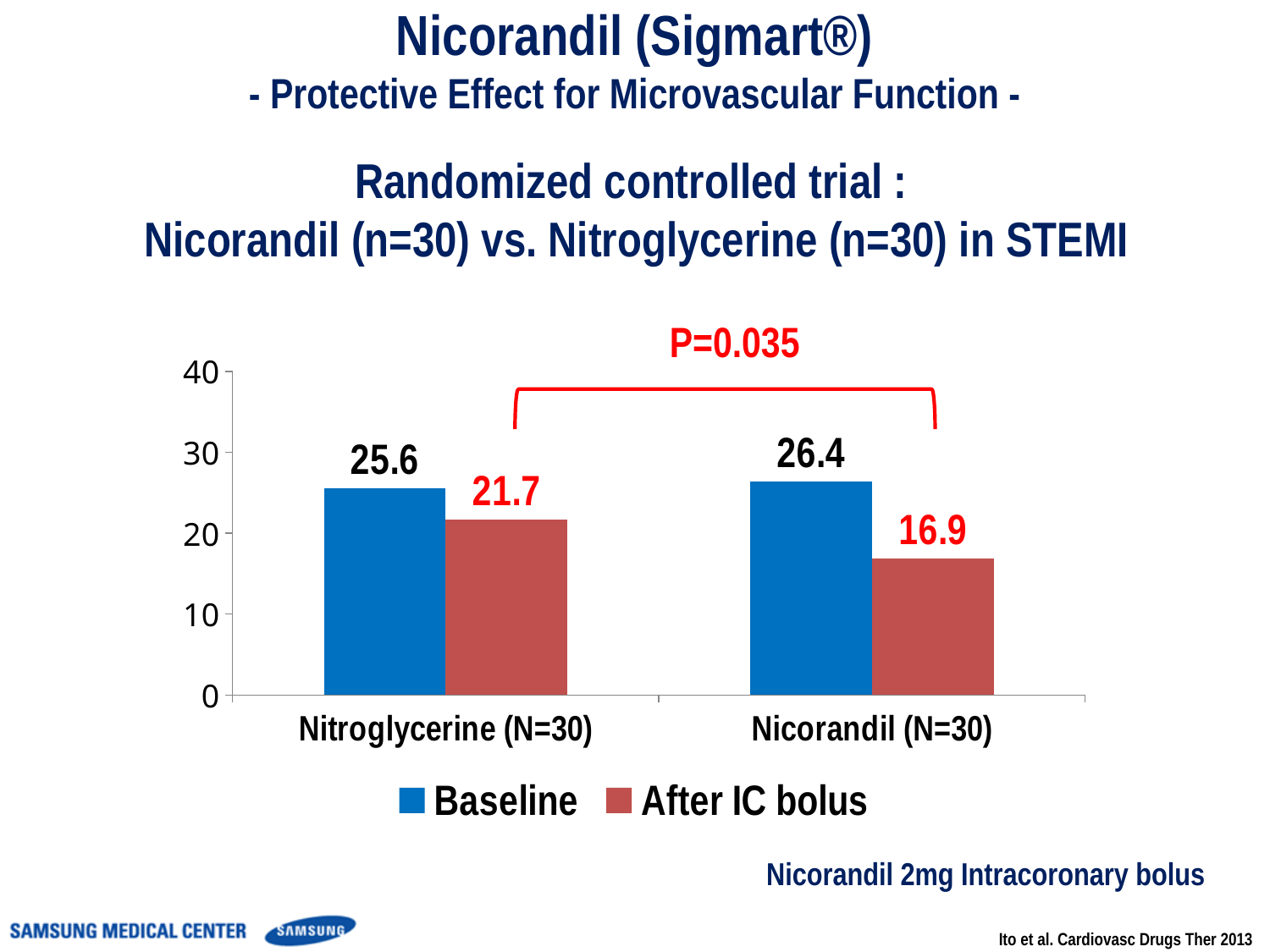
How many series does the legend list? 2 Which is larger: the After IC bolus value for Nitroglycerine (N=30) or for Nicorandil (N=30)? Nitroglycerine (N=30) What is the After IC bolus value for Nitroglycerine (N=30)? 21.7 What kind of chart is shown on the slide? Bar chart Which group has the lowest After IC bolus value? Nicorandil (N=30) What is the Baseline value for Nitroglycerine (N=30)? 25.6 What P value is shown above the chart? P=0.035 What is the difference between the Baseline and After IC bolus values for Nicorandil (N=30)? 9.5 What is the Baseline value for Nicorandil (N=30)? 26.4 What is the difference between the After IC bolus values for Nitroglycerine (N=30) and Nicorandil (N=30)? 4.8 How many categories are shown on the x axis? 2 What is the After IC bolus value for Nicorandil (N=30)? 16.9